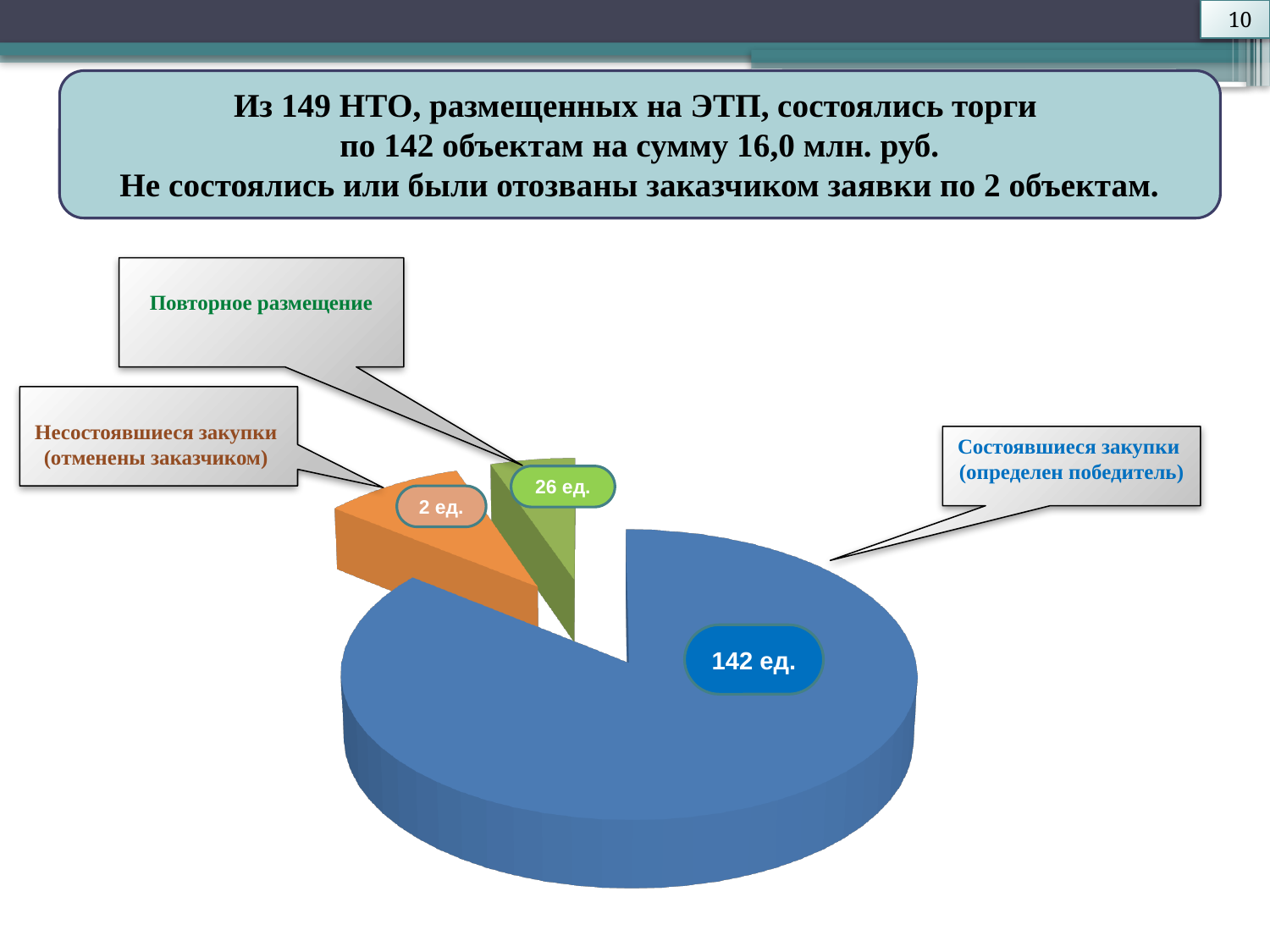
What kind of chart is shown on the slide? Pie chart What colour is the slice for "Повторное размещение"? Green What is the difference between the values for "Повторное размещение" and "Несостоявшиеся закупки"? 24 ед. What value is shown for the slice labelled "Повторное размещение"? 26 ед. What is the difference between the values for "Состоявшиеся закупки" and "Повторное размещение"? 116 ед. What value is shown for the slice labelled "Состоявшиеся закупки (определен победитель)"? 142 ед. How many slices does the pie chart have? 3 What is the total of all the values shown in the pie chart? 170 ед. What value is shown for the slice labelled "Несостоявшиеся закупки (отменены заказчиком)"? 2 ед. Which is larger: the value for "Повторное размещение" or the value for "Несостоявшиеся закупки"? Повторное размещение Which category has the smallest slice of the pie? Несостоявшиеся закупки (отменены заказчиком) Which category has the largest slice of the pie? Состоявшиеся закупки (определен победитель)